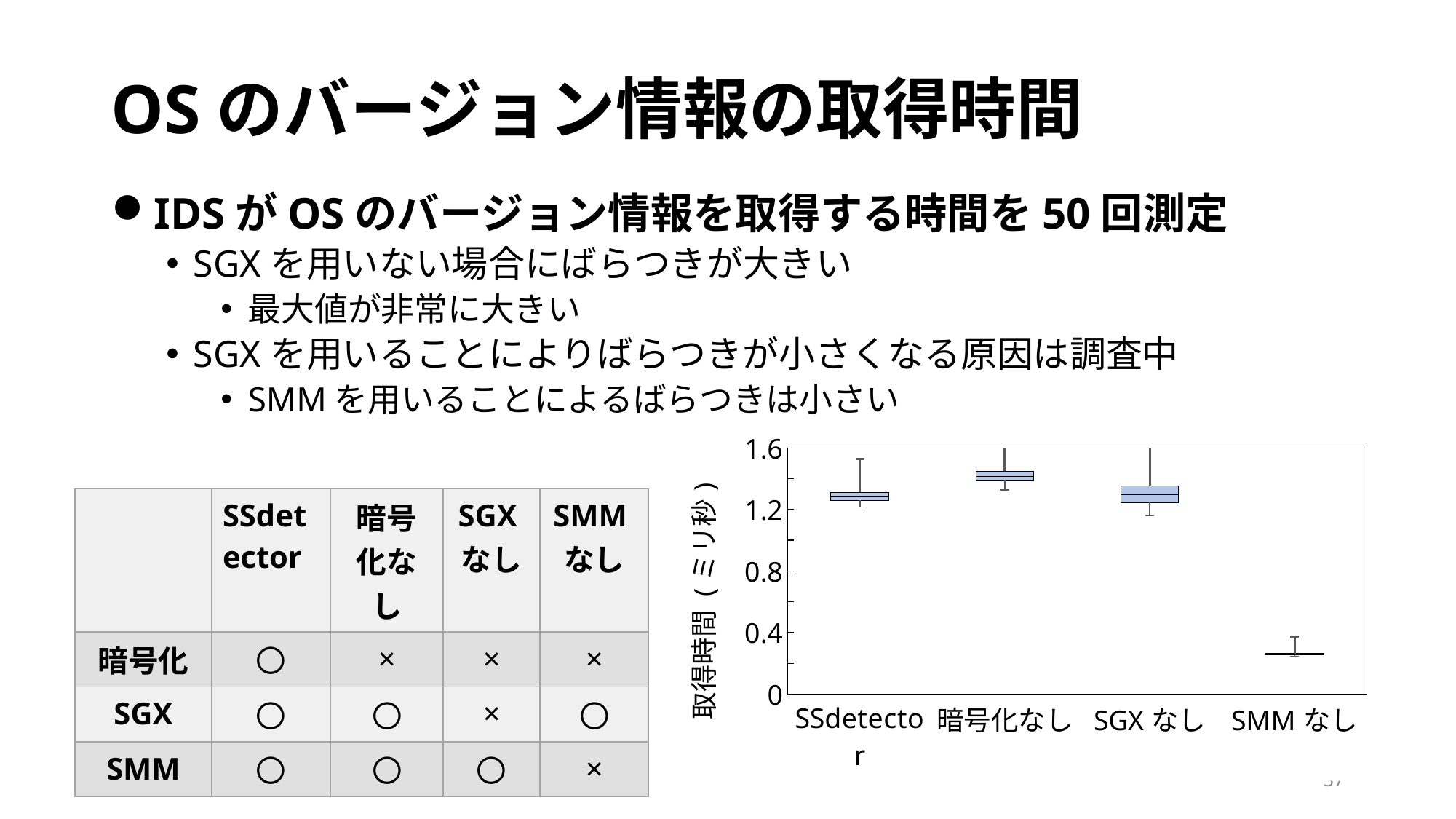
Which has the larger acquisition time, SSdetector or SMM なし? SSdetector Which category has the lowest acquisition time in the chart? SMM なし Which category has the highest median acquisition time in the chart? 暗号化なし Is the median value for 暗号化なし greater or less than 1.2? greater What is the label of the y axis of the chart? 取得時間（ミリ秒） What kind of chart is shown on the slide? Box plot What is the highest tick value shown on the y axis of the chart? 1.6 Which has the larger median acquisition time, 暗号化なし or SMM なし? 暗号化なし Is the value for SMM なし greater or less than 0.4? less How many categories are plotted along the x axis of the chart? 4 Is the median value for SSdetector greater or less than 1.2? greater